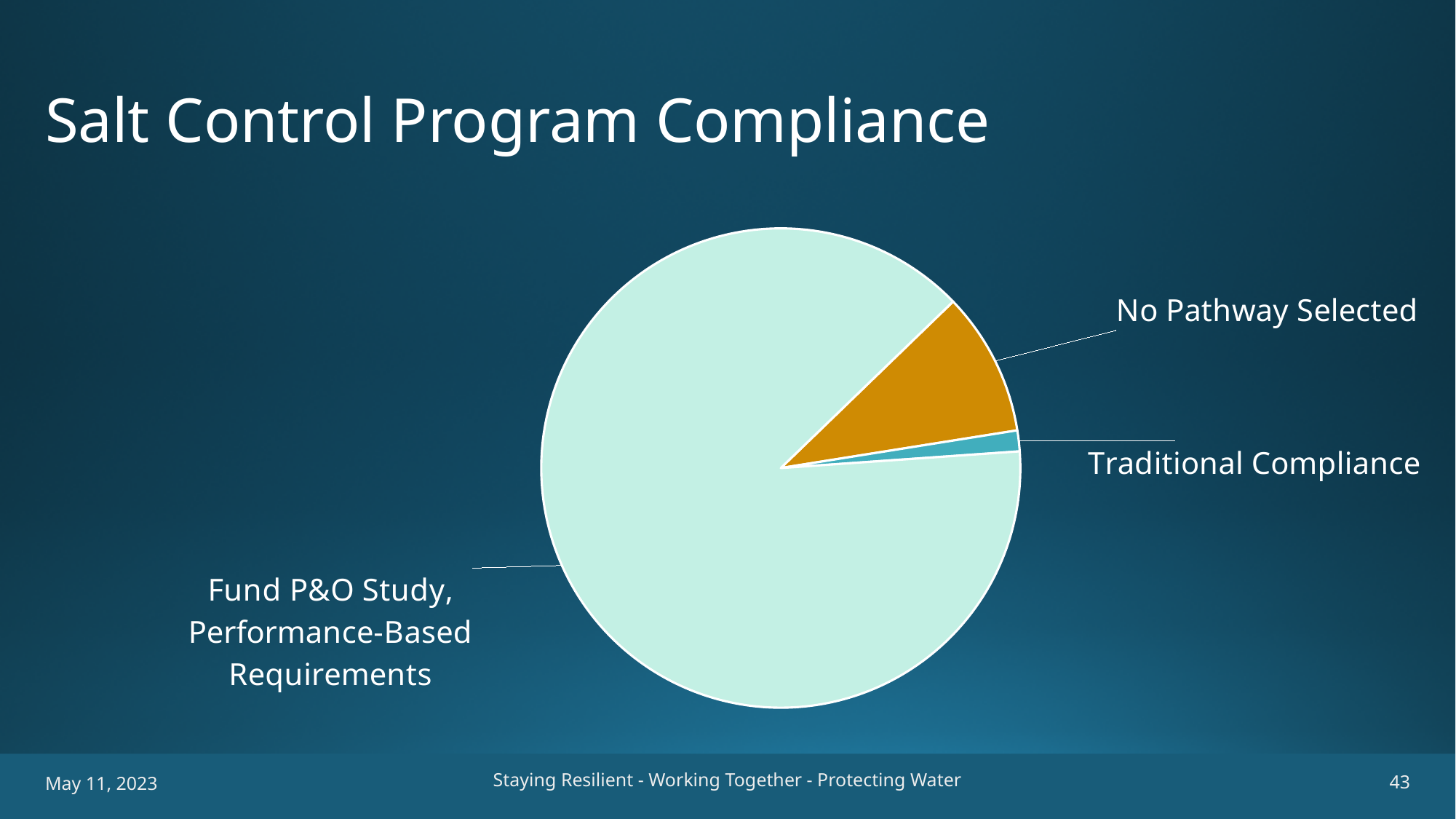
What kind of chart is shown on the slide? Pie chart Which slice is larger: No Pathway Selected or Traditional Compliance? No Pathway Selected Does the Fund P&O Study, Performance-Based Requirements slice make up more or less than half of the pie? More What is the title of the slide containing the pie chart? Salt Control Program Compliance Which category has the largest slice of the pie chart? Fund P&O Study, Performance-Based Requirements Which slice is larger: Fund P&O Study, Performance-Based Requirements or No Pathway Selected? Fund P&O Study, Performance-Based Requirements How many slices does the pie chart have? 3 What colour is the No Pathway Selected slice of the pie chart? Orange Which category has the smallest slice of the pie chart? Traditional Compliance